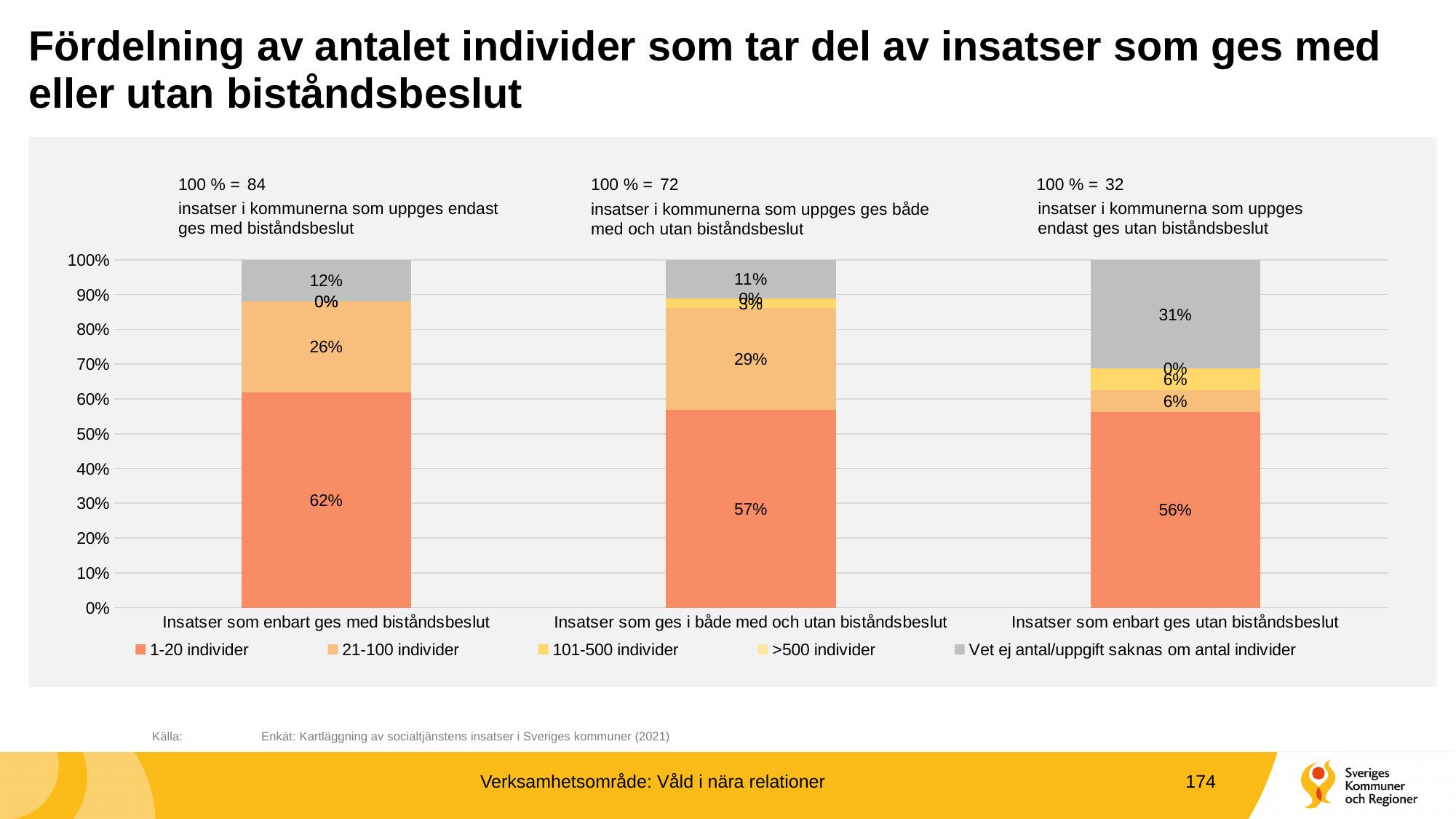
What is the 'Vet ej antal/uppgift saknas om antal individer' share for 'Insatser som enbart ges utan biståndsbeslut'? 31% What kind of chart is shown on the slide? Stacked bar chart What is the '21-100 individer' share for 'Insatser som ges i både med och utan biståndsbeslut'? 29% How many categories are shown on the x axis? 3 How many series does the legend list? 5 What is the '1-20 individer' share for 'Insatser som enbart ges utan biståndsbeslut'? 56% What is the difference in percentage points between the '1-20 individer' shares of 'Insatser som enbart ges med biståndsbeslut' and 'Insatser som ges i både med och utan biståndsbeslut'? 5 percentage points Which category has the lowest 'Vet ej antal/uppgift saknas om antal individer' share? Insatser som ges i både med och utan biståndsbeslut According to the annotation above the middle bar, how many insatser does 100 % correspond to for 'insatser i kommunerna som uppges ges både med och utan biståndsbeslut'? 72 What percentage of 'Insatser som enbart ges med biståndsbeslut' falls in the '1-20 individer' category? 62% Which is larger: the '21-100 individer' share for 'Insatser som enbart ges med biståndsbeslut' or for 'Insatser som ges i både med och utan biståndsbeslut'? Insatser som ges i både med och utan biståndsbeslut Which category has the highest '1-20 individer' share? Insatser som enbart ges med biståndsbeslut